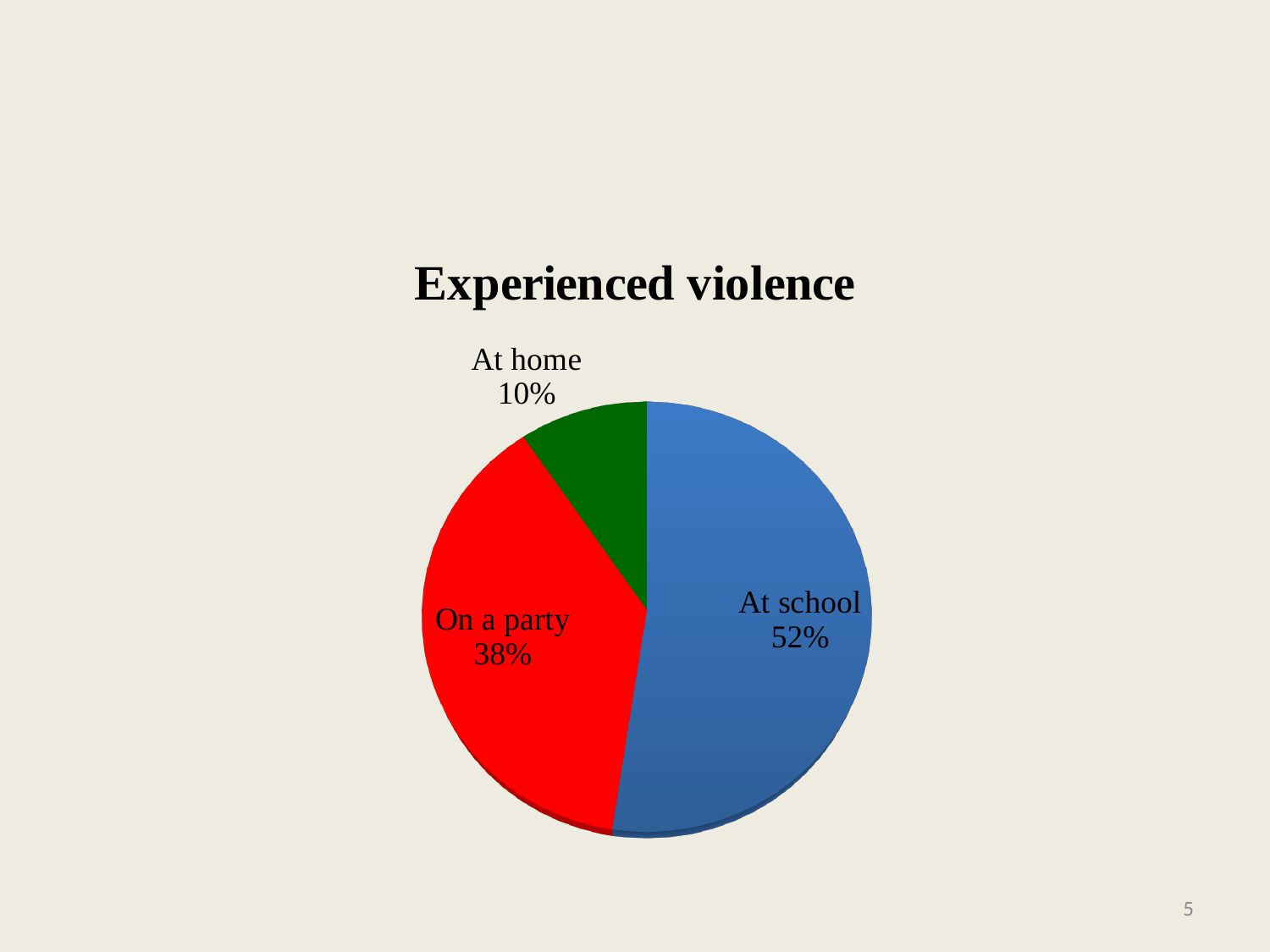
What is the difference in percentage points between 'On a party' and 'At home'? 28 What is the difference in percentage points between 'At school' and 'On a party'? 14 Which is larger, the share for 'On a party' or the share for 'At home'? On a party Which category has the smallest share of the pie? At home What percentage of the pie is 'On a party'? 38% Which category has the largest share of the pie? At school How many slices does the pie chart have? 3 What kind of chart is shown on the slide? pie chart What percentage of the pie is 'At school'? 52% What colour is the 'At home' slice? green What percentage of the pie is 'At home'? 10% What is the title of the chart? Experienced violence